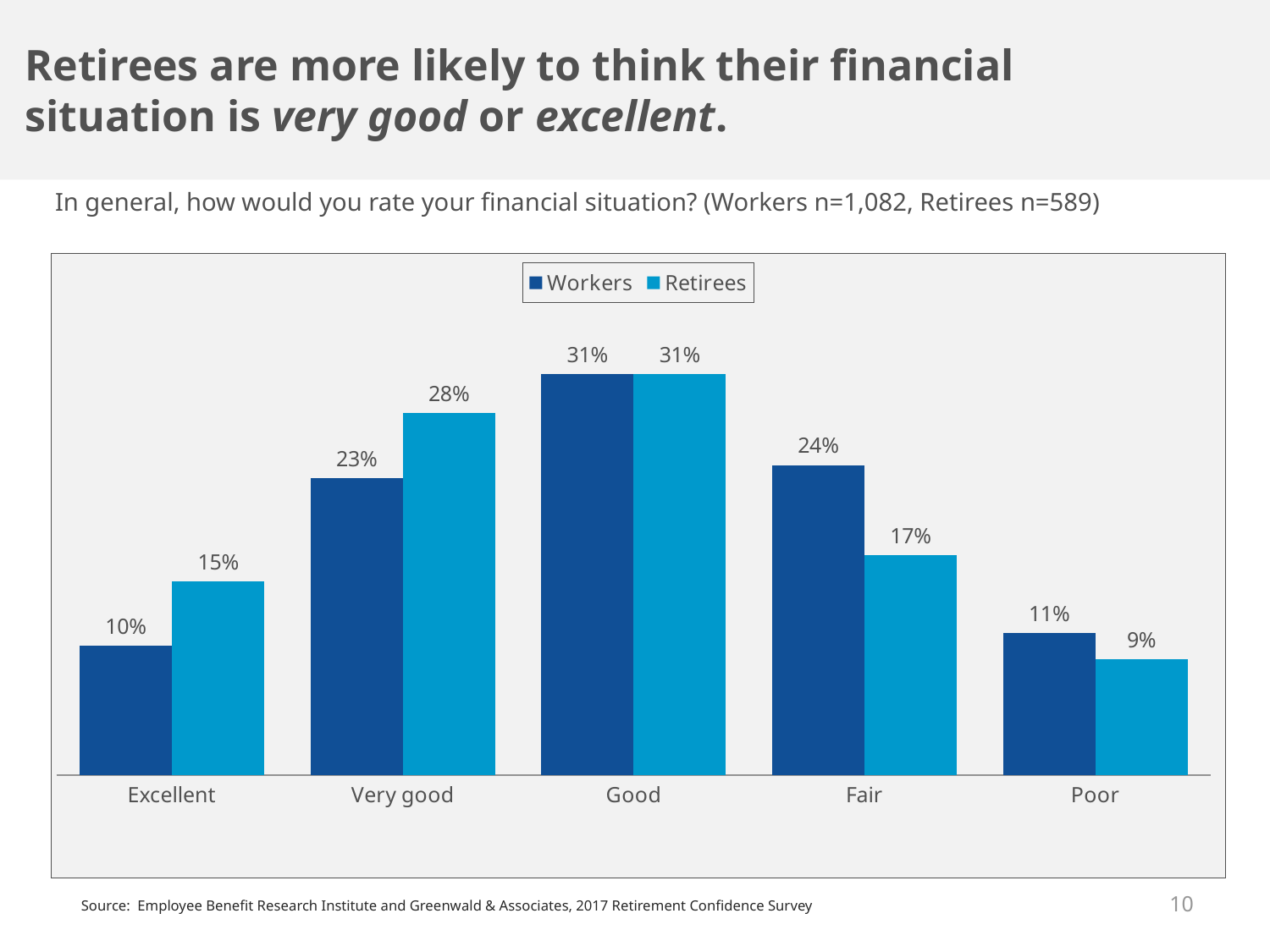
Which category has the highest value for Workers? Good Which is larger for Poor: the Workers value or the Retirees value? Workers What is the difference between the Workers and Retirees values for Fair? 7% Which is larger for Excellent: the Workers value or the Retirees value? Retirees What is the difference between the Retirees and Workers values for Very good? 5% How many series does the legend list? 2 How many categories are shown on the x axis? 5 What percentage of Retirees rate their financial situation as Fair? 17% Which category has the lowest value for Retirees? Poor What percentage of Retirees rate their financial situation as Very good? 28% What kind of chart is shown on the slide? Bar chart What percentage of Workers rate their financial situation as Excellent? 10%